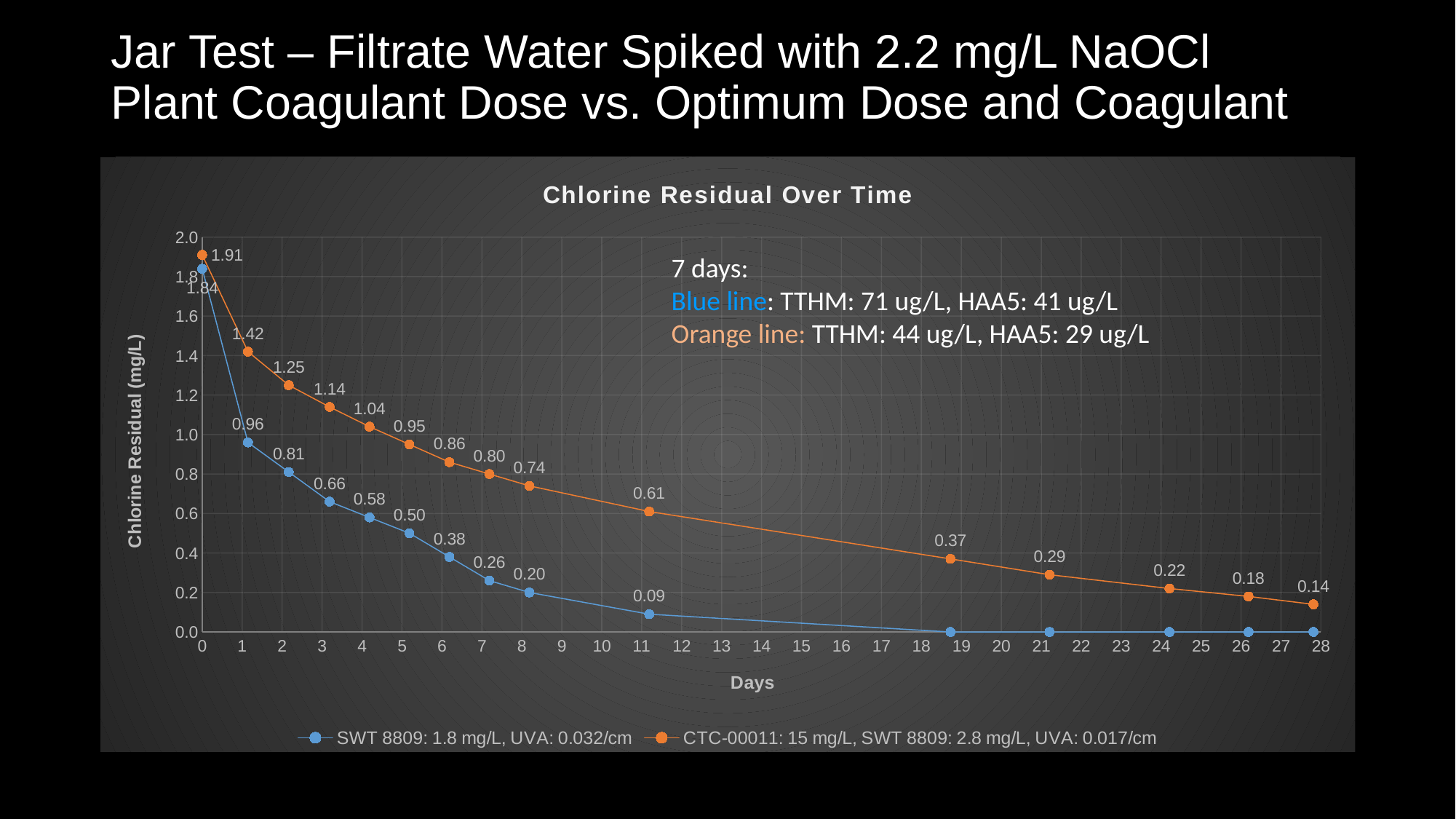
At day 1, what is the difference between the orange line value and the blue line value? 0.46 What is the chlorine residual for the orange line at day 28? 0.14 At day 7, what is the difference between the orange line value (0.80) and the blue line value (0.26)? 0.54 What is the chlorine residual for the orange line (CTC-00011: 15 mg/L, SWT 8809: 2.8 mg/L) at day 0? 1.91 What kind of chart is shown on the slide? line chart What is the highest chlorine residual value on the orange line? 1.91 What is the title of the chart? Chlorine Residual Over Time At day 11, which series has the higher chlorine residual, the blue line or the orange line? orange line What is the chlorine residual for the blue line at day 11? 0.09 What is the chlorine residual for the blue line (SWT 8809: 1.8 mg/L) at day 0? 1.84 How many series does the legend of the chart list? 2 Do the chlorine residual values rise or fall as the days increase? fall